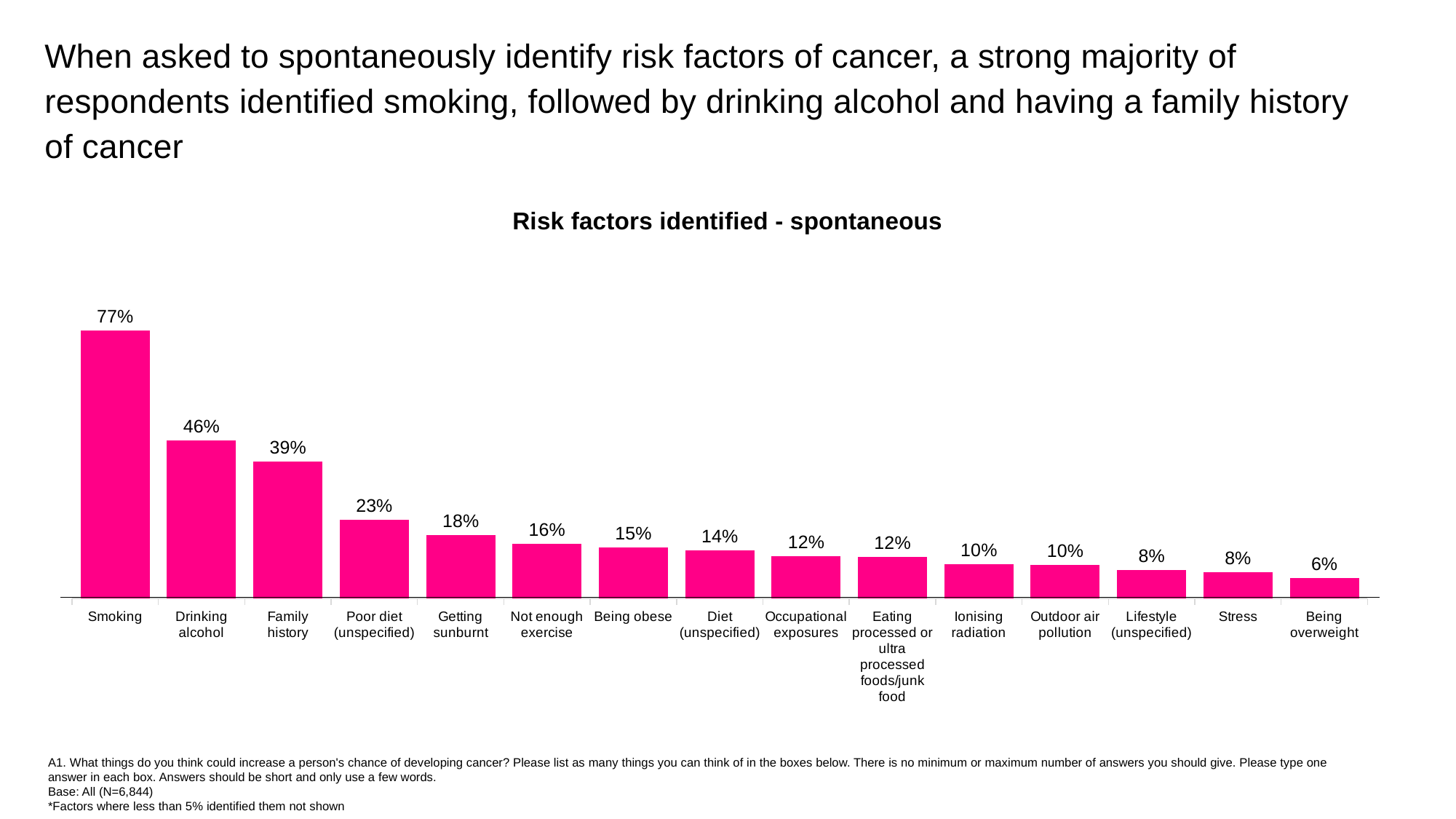
What is the title of the chart? Risk factors identified - spontaneous What is the difference between the values for Family history and Poor diet (unspecified)? 16% What is the difference between the values for Smoking and Drinking alcohol? 31% What is the value for Getting sunburnt? 18% Which is larger, the value for Not enough exercise or the value for Stress? Not enough exercise Which risk factor has the highest value? Smoking How many risk factors are shown in the chart? 15 Do the values rise or fall from left to right across the chart? Fall What percentage of respondents identified smoking as a risk factor? 77% What kind of chart is shown on the slide? Bar chart Which risk factor has the lowest value? Being overweight What is the value for Ionising radiation? 10%